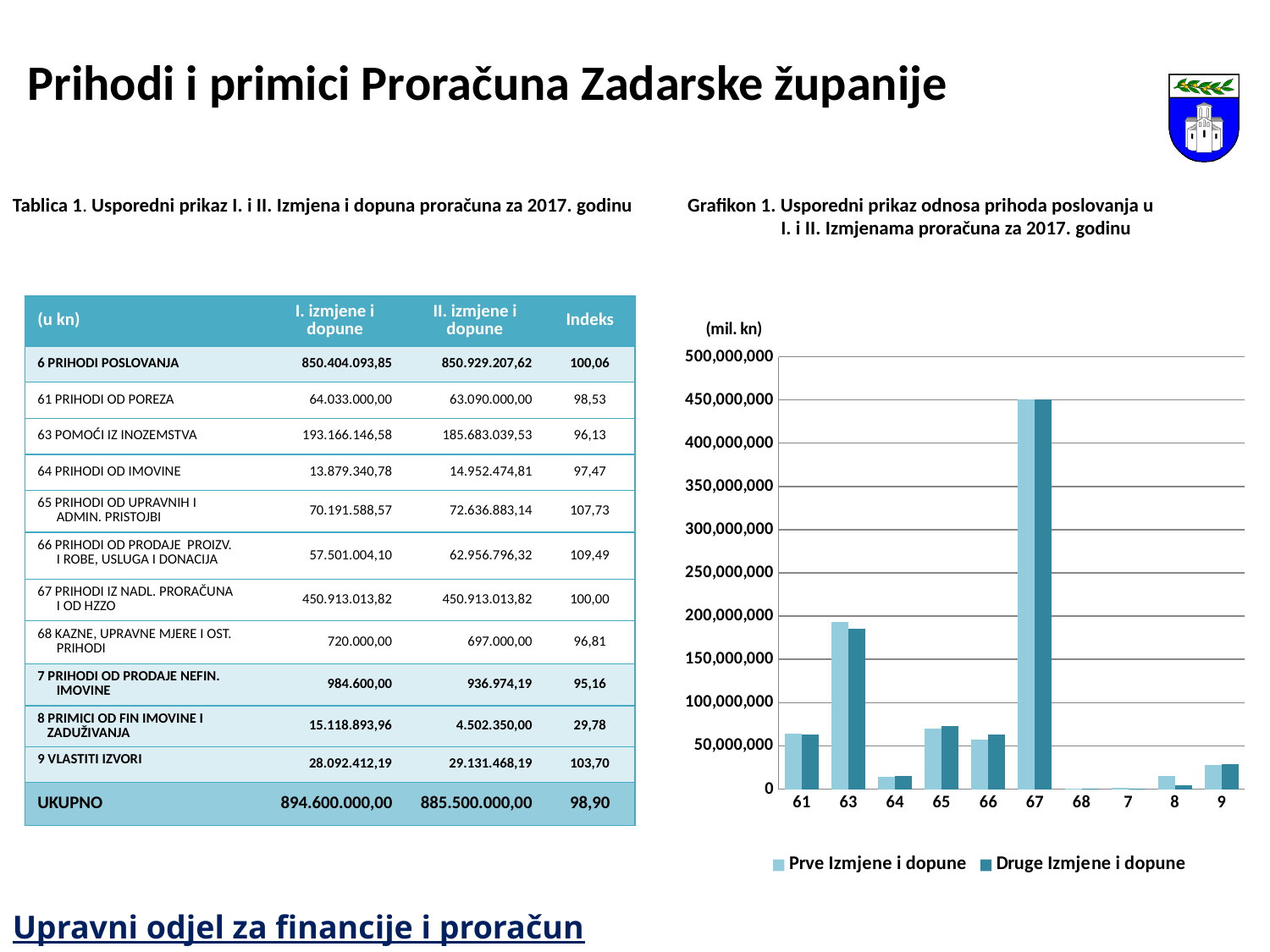
What kind of chart is Grafikon 1? bar chart How many categories are shown on the x axis of Grafikon 1? 10 How many series does the legend of Grafikon 1 list? 2 In Grafikon 1, for category 8, which series has the larger value, Prve Izmjene i dopune or Druge Izmjene i dopune? Prve Izmjene i dopune In Grafikon 1, is the value for category 67 in the Prve Izmjene i dopune series greater or less than 400,000,000? greater In Grafikon 1, which category has the highest bars? 67 In Grafikon 1, is the value for category 64 in the Druge Izmjene i dopune series greater or less than 50,000,000? less What unit label is shown above the y axis of Grafikon 1? (mil. kn) In Grafikon 1, which category has the larger Prve Izmjene i dopune value, 63 or 65? 63 What are the two legend entries in Grafikon 1? Prve Izmjene i dopune; Druge Izmjene i dopune In Grafikon 1, is the value for category 65 in the Druge Izmjene i dopune series greater or less than 50,000,000? greater